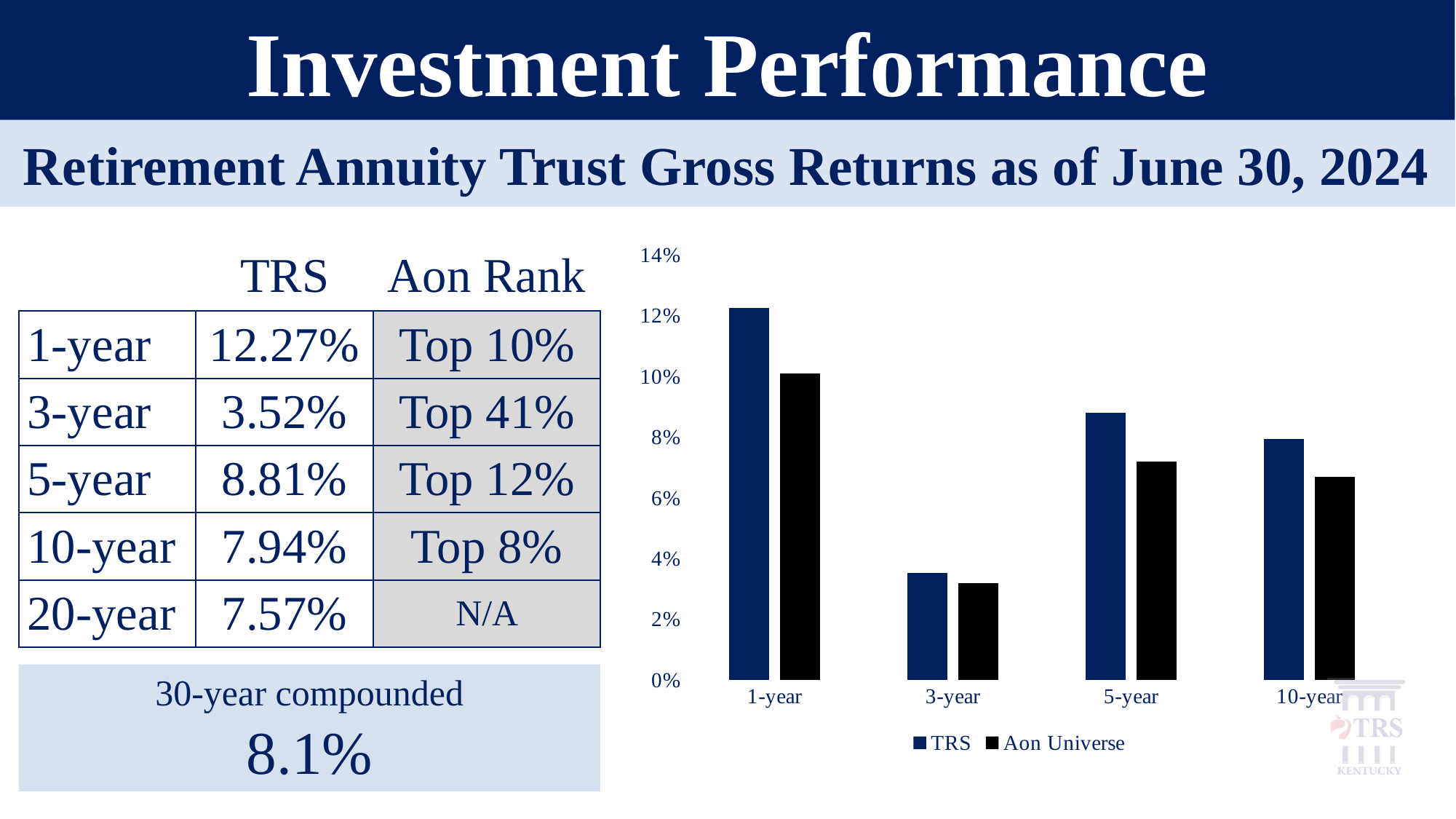
Is the Aon Universe value for the 3-year period greater or less than 4%? less Is the Aon Universe value for the 1-year period greater or less than 8%? greater Which series does the black bar represent in the chart? Aon Universe For which period is the TRS bar the shortest in the chart? 3-year What kind of chart is shown on the slide? bar chart How many time-period categories are plotted on the chart's x axis? 4 For which period is the TRS bar the tallest in the chart? 1-year How many series does the chart legend list? 2 For which period is the Aon Universe bar the shortest in the chart? 3-year Is the Aon Universe value for the 10-year period greater or less than 8%? less In the chart, which is larger for the 5-year period, TRS or Aon Universe? TRS In the chart, which is larger for the 1-year period, TRS or Aon Universe? TRS